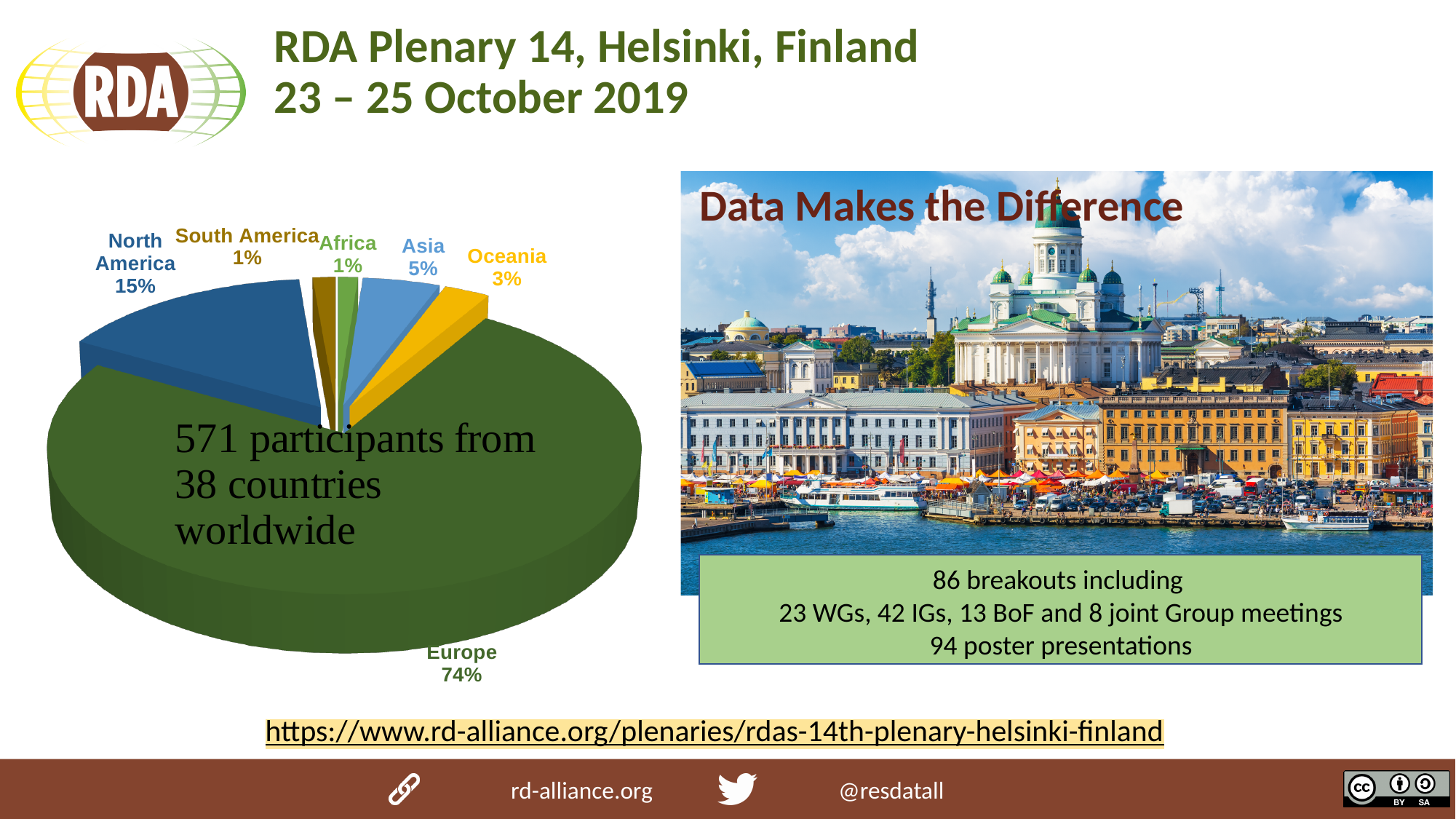
What kind of chart is shown on the slide? pie chart Which is larger, the share for Asia or the share for Oceania? Asia What share of participants came from Asia? 5% What share of participants came from Oceania? 3% What share of participants came from North America? 15% What text is written inside the pie chart? 571 participants from 38 countries worldwide What is the difference in percentage points between Europe and North America? 59 Which region has the largest slice of the pie? Europe What is the difference in percentage points between North America and Asia? 10 How many regions are shown in the pie chart? 6 Which two regions share the smallest slice value of 1%? South America and Africa What share of participants came from Europe? 74%